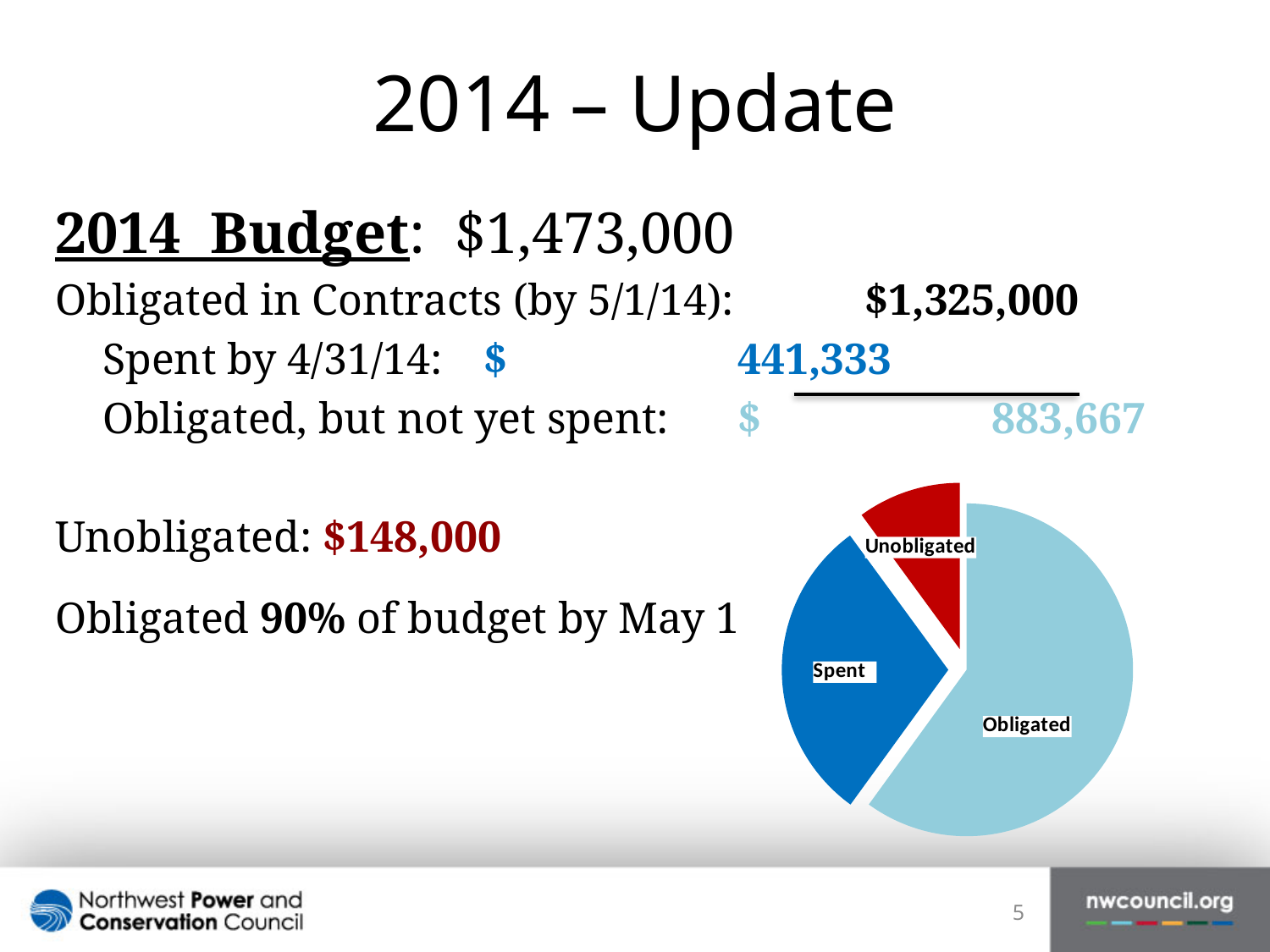
What are the labels of the three slices in the pie chart? Obligated, Spent, Unobligated How many slices does the pie chart have? 3 What kind of chart is shown on the slide? pie chart Which slice of the pie chart is the smallest? Unobligated What colour is the Unobligated slice in the pie chart? red In the pie chart, which slice is larger, Spent or Unobligated? Spent Which slice of the pie chart is the largest? Obligated In the pie chart, which slice is larger, Obligated or Spent? Obligated